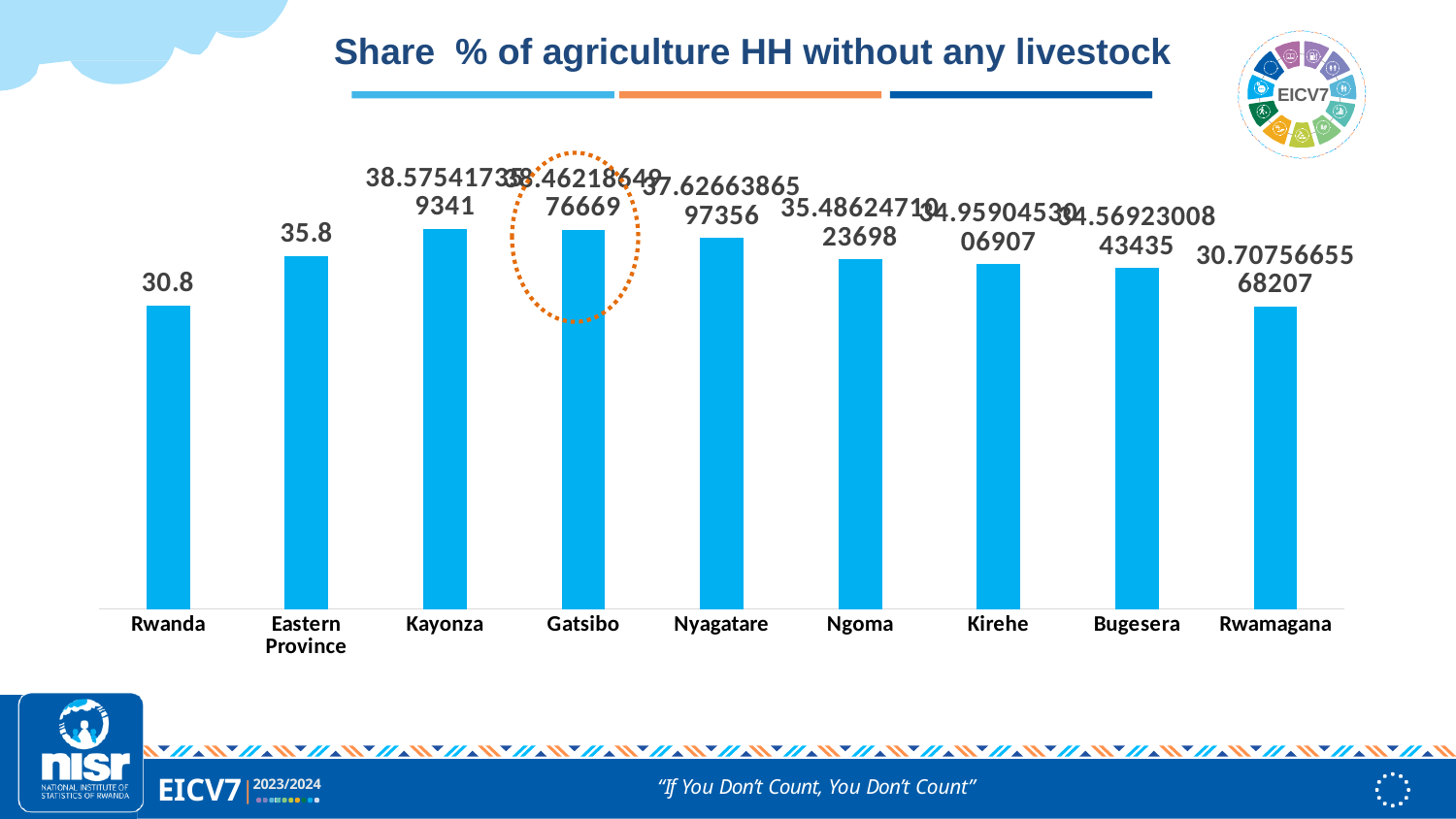
Which has the larger value, Gatsibo or Ngoma? Gatsibo What is the title of the chart? Share % of agriculture HH without any livestock Which has the larger value, Kayonza or Rwamagana? Kayonza What is the value for Rwanda? 30.8 How many categories are shown on the x axis? 9 What is the difference between the values for Eastern Province and Rwanda? 5.0 Which category's bar is highlighted with a dotted orange circle? Gatsibo Which has the larger value, Eastern Province or Rwanda? Eastern Province What is the value for Eastern Province? 35.8 Do the values rise or fall from Kayonza to Rwamagana along the x axis? Fall What kind of chart is shown on the slide? Bar chart